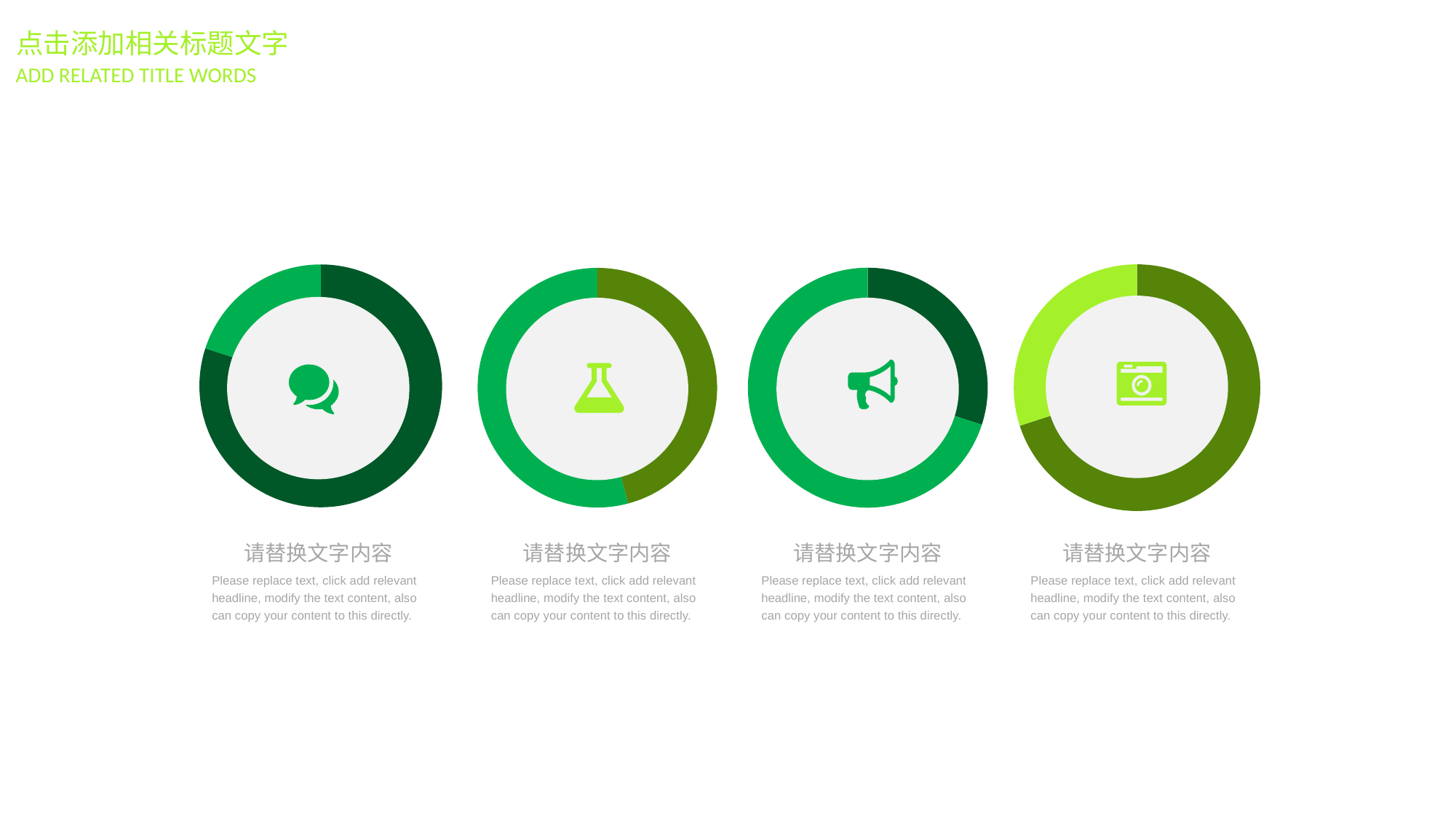
How many donut charts are on the slide? 4 What icon is shown in the centre of the second donut chart from the left? A flask How many segments does the leftmost donut chart have? 2 What kind of chart is shown in each of the four circles on the slide? Donut chart Does the leftmost donut chart show any data labels or percentage values? No How many segments does the rightmost donut chart have? 2 In the second donut chart from the left, which segment is larger, the olive green one or the bright green one? The bright green one In the leftmost donut chart, which segment is larger, the dark green one or the bright green one? The dark green one In the rightmost donut chart, which segment is larger, the olive green one or the lime green one? The olive green one